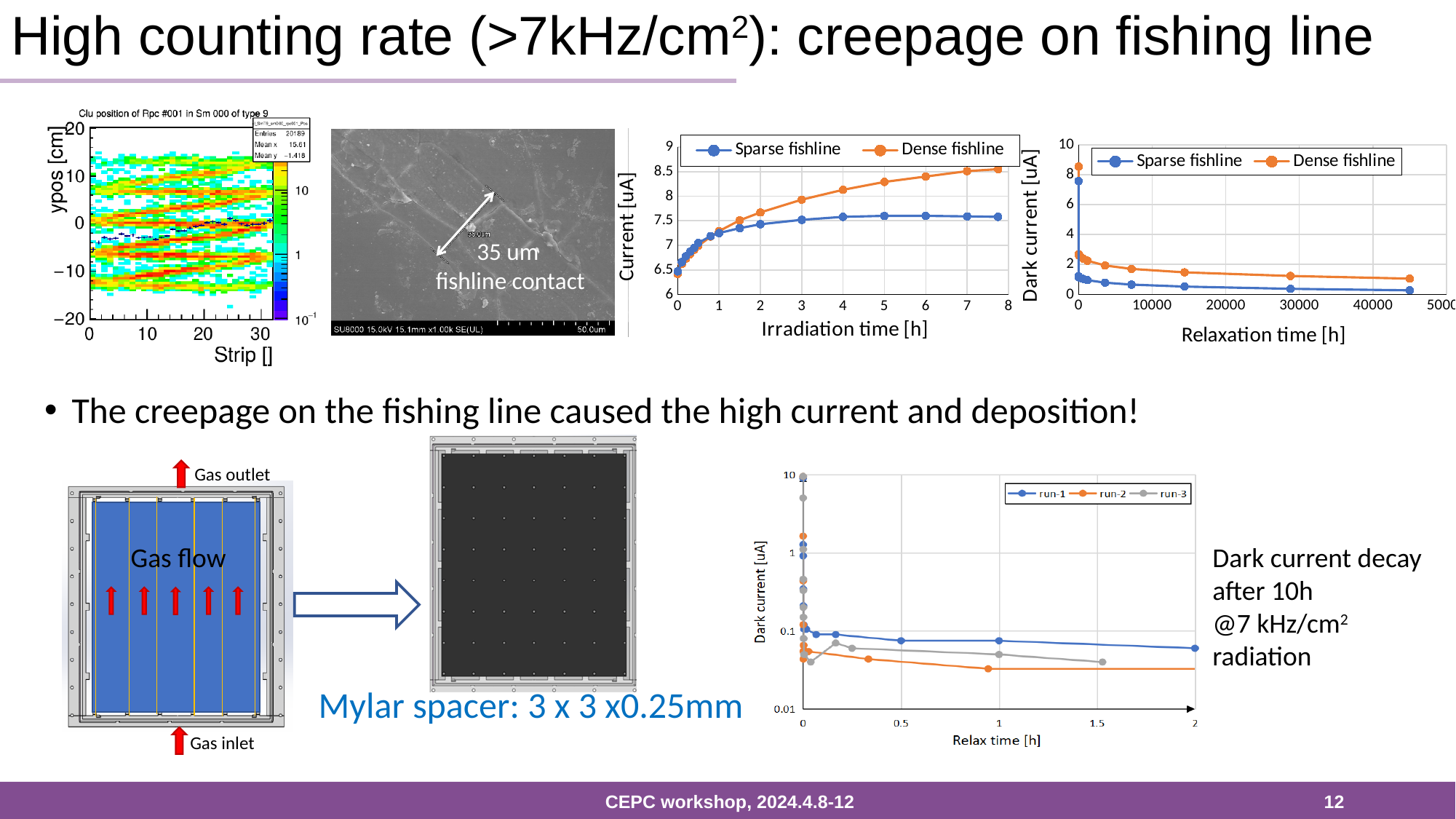
In the chart with x axis 'Relaxation time [h]', is the Dense fishline dark current at 30000 h greater or less than 2? less In the chart with x axis 'Irradiation time [h]', is the Sparse fishline current at 7 h greater or less than 8? less In the chart with x axis 'Relaxation time [h]', does the Sparse fishline dark current rise or fall as relaxation time increases? fall In the chart with x axis 'Relaxation time [h]', which series has the higher dark current at 10000 h, Sparse fishline or Dense fishline? Dense fishline In the chart with x axis 'Irradiation time [h]', how many series does the legend list? 2 In the bottom chart with x axis 'Relax time [h]', how many series does the legend list? 3 In the bottom chart with x axis 'Relax time [h]', which series has the higher dark current at 1 h, run-1 or run-2? run-1 In the chart with x axis 'Irradiation time [h]', does the Dense fishline series rise or fall as irradiation time increases? rise What is the y axis label of the chart with x axis 'Irradiation time [h]'? Current [uA] What kind of chart is the one with x axis 'Irradiation time [h]'? line chart In the chart with x axis 'Irradiation time [h]', which series has the larger current at 7 h, Sparse fishline or Dense fishline? Dense fishline In the chart with x axis 'Irradiation time [h]', is the Dense fishline current at 7 h greater or less than 8? greater